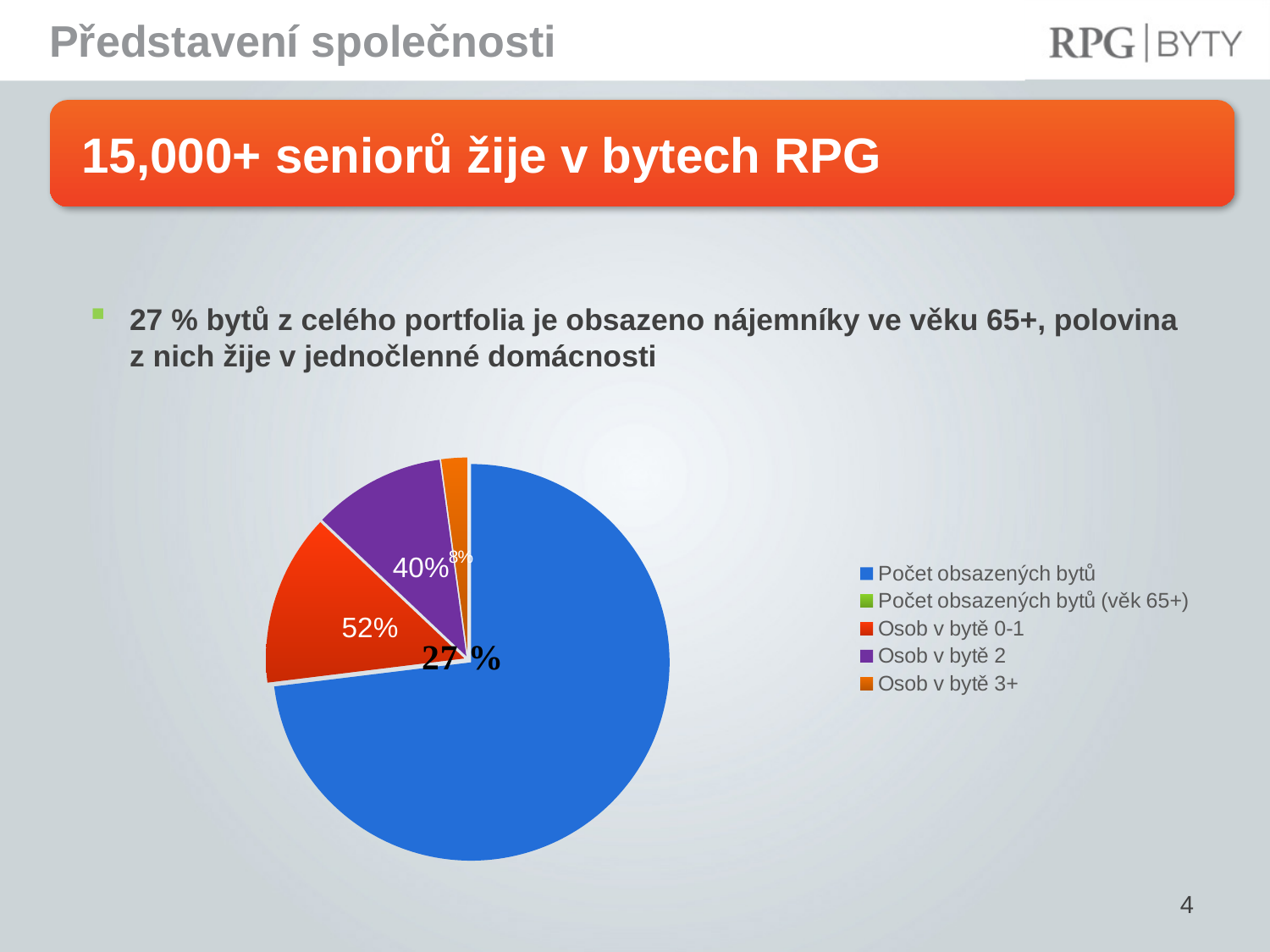
What colour is the 'Osob v bytě 2' slice in the pie chart? purple What kind of chart is shown on the slide? pie chart What is the difference in percentage points between the 'Osob v bytě 0-1' slice (52%) and the 'Osob v bytě 2' slice (40%)? 12 What percentage is labelled on the 'Osob v bytě 3+' slice of the pie chart? 8% Which legend entry is shown in blue? Počet obsazených bytů How many entries does the legend of the pie chart list? 5 What percentage is labelled on the 'Osob v bytě 0-1' slice of the pie chart? 52% Which of the labelled slices, 'Osob v bytě 0-1' or 'Osob v bytě 2', is larger? Osob v bytě 0-1 What percentage value is printed in large text near the centre of the pie chart? 27 % What percentage is labelled on the 'Osob v bytě 2' slice of the pie chart? 40% Which of the labelled slices, 'Osob v bytě 2' or 'Osob v bytě 3+', is smaller? Osob v bytě 3+ Which slice of the pie chart is the largest? Počet obsazených bytů